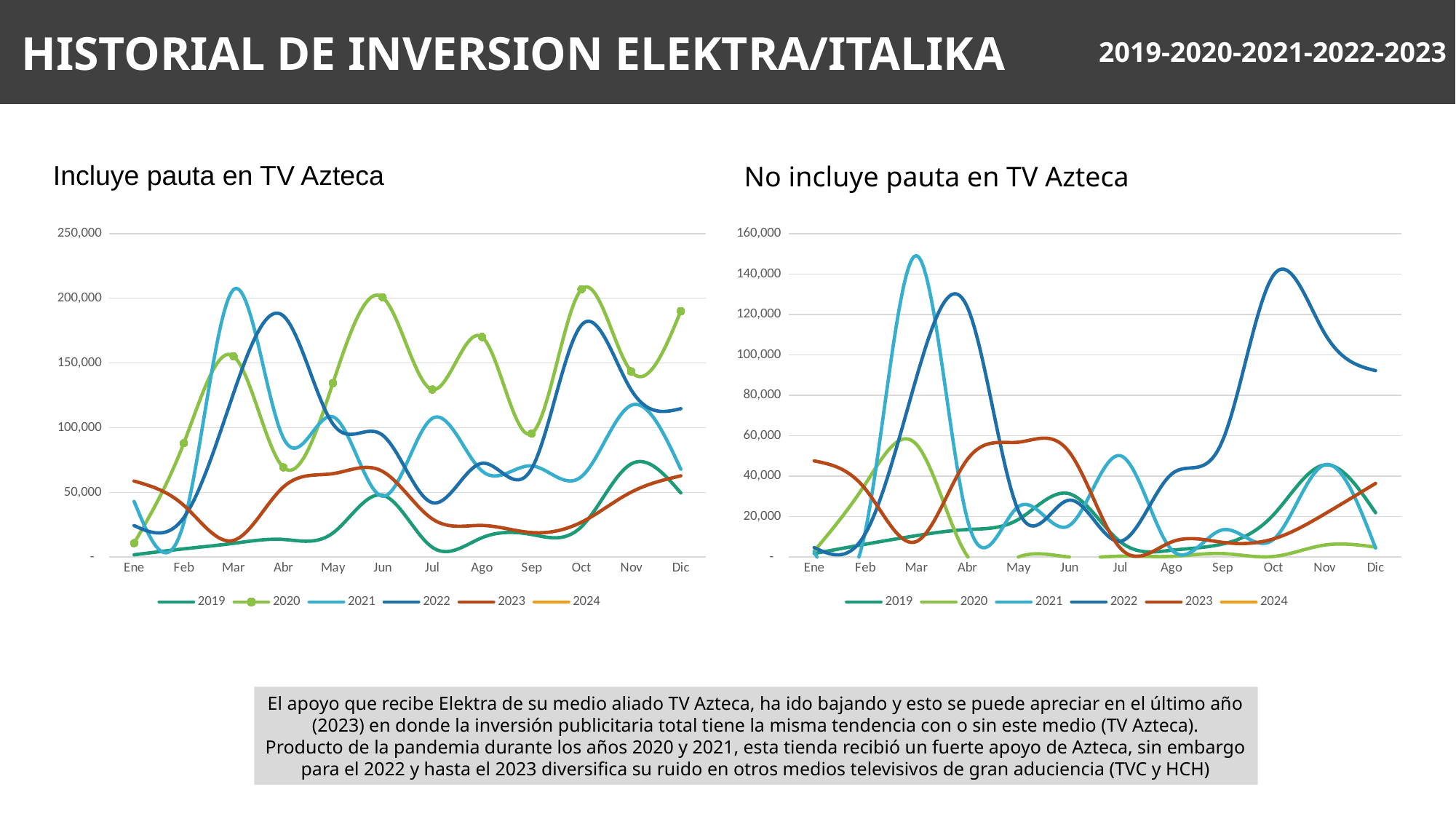
What is the title of the chart on the right side of the slide? No incluye pauta en TV Azteca What type of chart is the 'Incluye pauta en TV Azteca' chart? line chart In the 'No incluye pauta en TV Azteca' chart, does the 2022 line rise or fall from Oct to Dic? fall In the 'Incluye pauta en TV Azteca' chart, is the value for 2022 in Abr greater or less than 150,000? greater In the 'No incluye pauta en TV Azteca' chart, is the value for 2022 in Oct greater or less than 120,000? greater In the 'Incluye pauta en TV Azteca' chart, is the value for 2019 in Jul greater or less than 50,000? less How many series does the legend of the 'No incluye pauta en TV Azteca' chart list? 6 How many months are shown on the x axis of the 'Incluye pauta en TV Azteca' chart? 12 In the 'No incluye pauta en TV Azteca' chart, which year has the highest value in Oct? 2022 In the 'Incluye pauta en TV Azteca' chart, which year has the highest value in Abr? 2022 In the 'Incluye pauta en TV Azteca' chart, which is larger in Jun: the value for 2020 or the value for 2022? 2020